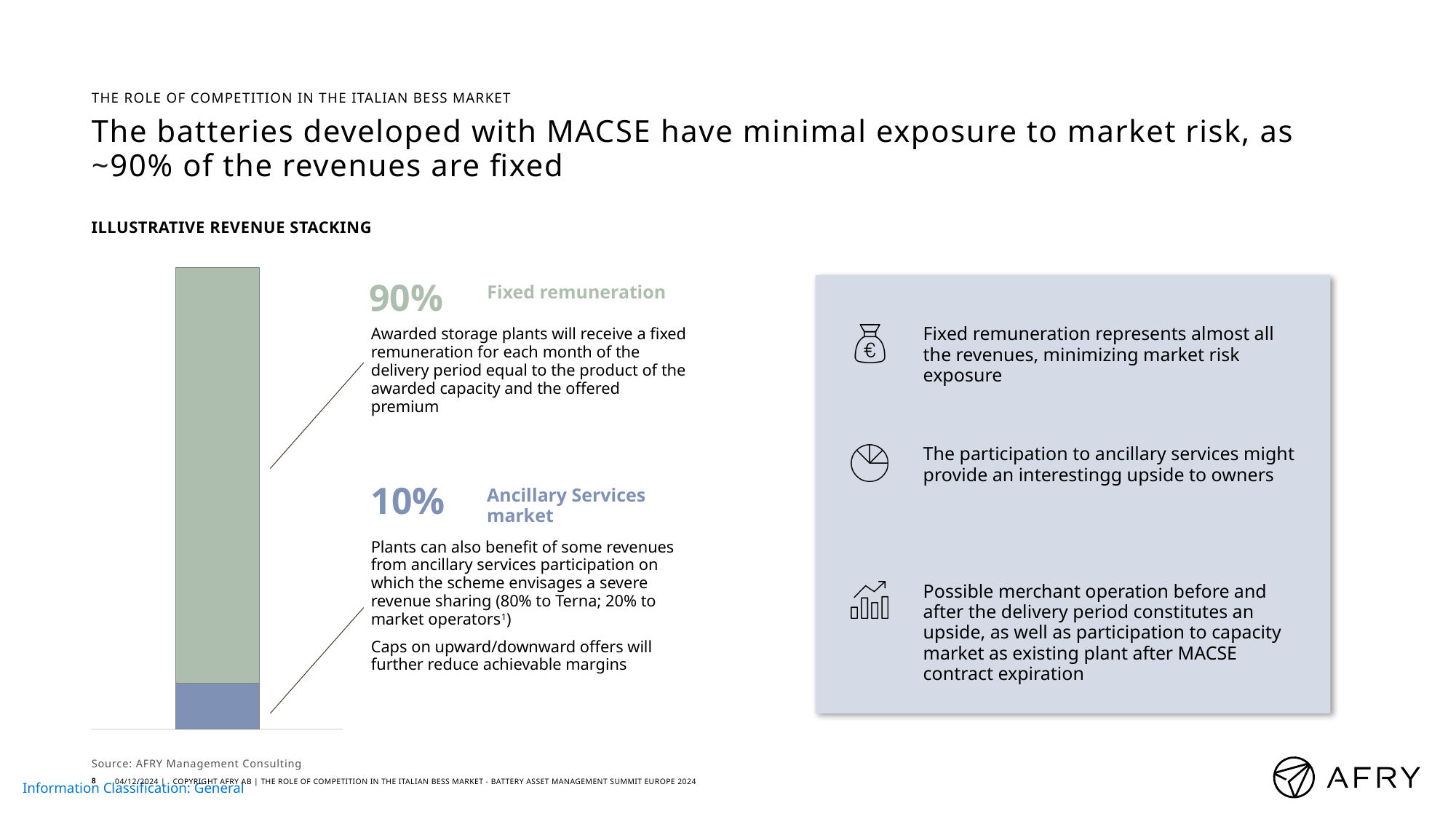
What is the total of the two segments in the stacked bar? 100% How many segments make up the stacked bar in the chart? 2 Which segment of the stacked bar is the largest? Fixed remuneration What share of revenues does the Ancillary Services market segment represent in the Illustrative Revenue Stacking chart? 10% What is the title of the chart on the slide? ILLUSTRATIVE REVENUE STACKING Which segment of the stacked bar is shown in blue? Ancillary Services market What kind of chart is shown under the heading Illustrative Revenue Stacking? Stacked bar chart What share of revenues does the Fixed remuneration segment represent in the Illustrative Revenue Stacking chart? 90% What is the difference in percentage points between the Fixed remuneration share and the Ancillary Services market share? 80 percentage points Which is larger, the Fixed remuneration share or the Ancillary Services market share? Fixed remuneration Which segment of the stacked bar is the smallest? Ancillary Services market